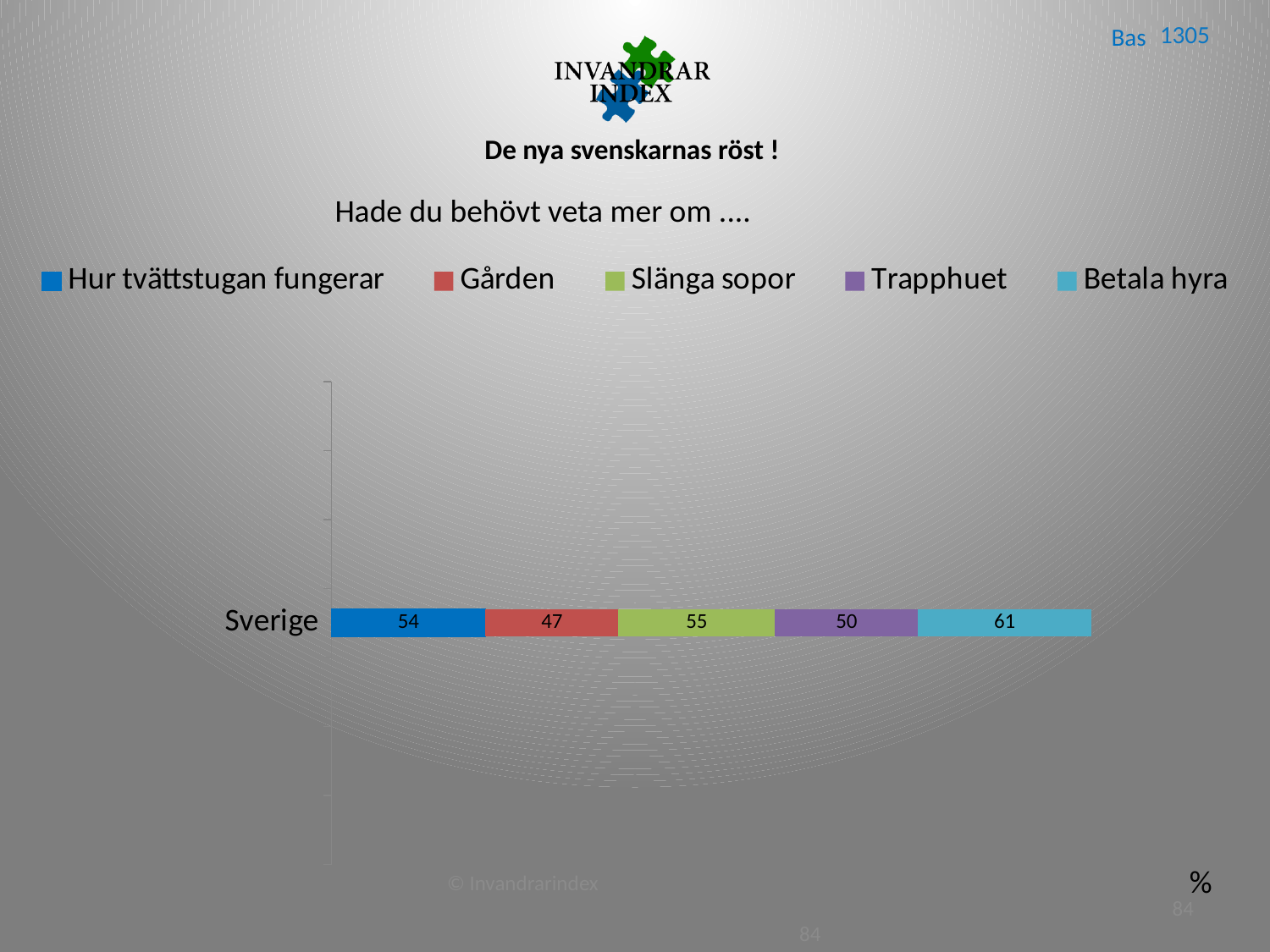
What is the value for Hur tvättstugan fungerar for Sverige? 54 What is the value for Trapphuet for Sverige? 50 What is the value for Gården for Sverige? 47 How many series does the legend list? 5 What is the title of the chart? Hade du behövt veta mer om .... How many categories are shown on the chart? 1 Which is larger for Sverige, Slänga sopor or Trapphuet? Slänga sopor What is the difference between the values for Betala hyra and Gården for Sverige? 14 Which series has the highest value for Sverige? Betala hyra What kind of chart is shown on the slide? Stacked bar chart What is the value for Betala hyra for Sverige? 61 Which series has the lowest value for Sverige? Gården